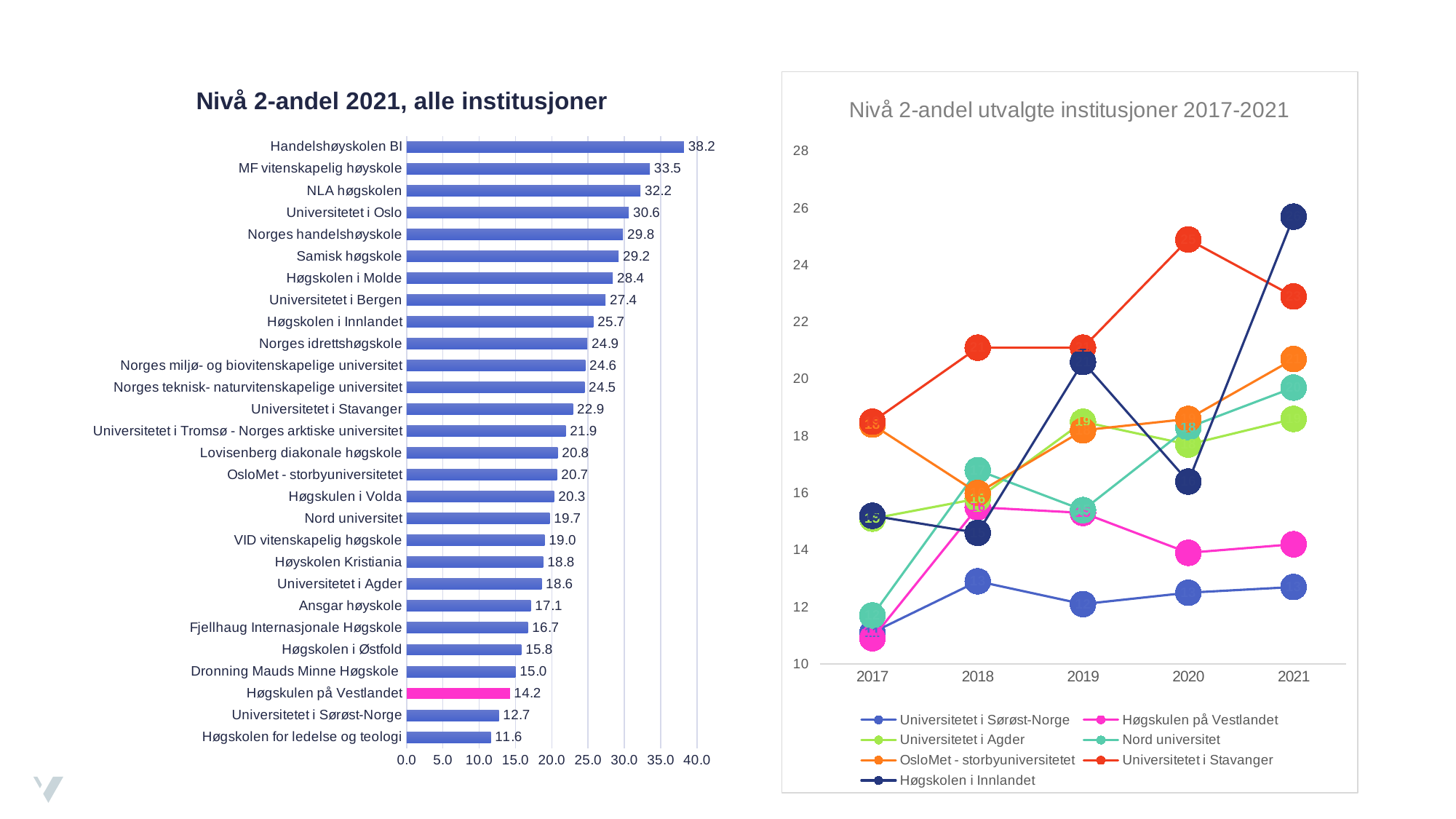
How many series does the legend of the chart 'Nivå 2-andel utvalgte institusjoner 2017-2021' list? 7 In the chart 'Nivå 2-andel 2021, alle institusjoner', which institution has the lowest value? Høgskolen for ledelse og teologi In the chart 'Nivå 2-andel 2021, alle institusjoner', which bar is highlighted in pink? Høgskulen på Vestlandet In the chart 'Nivå 2-andel 2021, alle institusjoner', what is the value for Handelshøyskolen BI? 38.2 How many institutions are shown in the chart 'Nivå 2-andel 2021, alle institusjoner'? 28 In the chart 'Nivå 2-andel utvalgte institusjoner 2017-2021', is the value for Universitetet i Stavanger in 2020 greater or less than 24? greater In the chart 'Nivå 2-andel 2021, alle institusjoner', what is the difference between Universitetet i Oslo and Universitetet i Bergen? 3.2 What kind of chart is 'Nivå 2-andel 2021, alle institusjoner'? Bar chart In the chart 'Nivå 2-andel 2021, alle institusjoner', what is the value for Høgskulen på Vestlandet? 14.2 In the chart 'Nivå 2-andel utvalgte institusjoner 2017-2021', does the value for Høgskolen i Innlandet rise or fall from 2020 to 2021? rise In the chart 'Nivå 2-andel utvalgte institusjoner 2017-2021', is the value for Universitetet i Sørøst-Norge in 2019 greater or less than 14? less In the chart 'Nivå 2-andel 2021, alle institusjoner', which is larger: Høgskolen i Molde or Høgskolen i Innlandet? Høgskolen i Molde